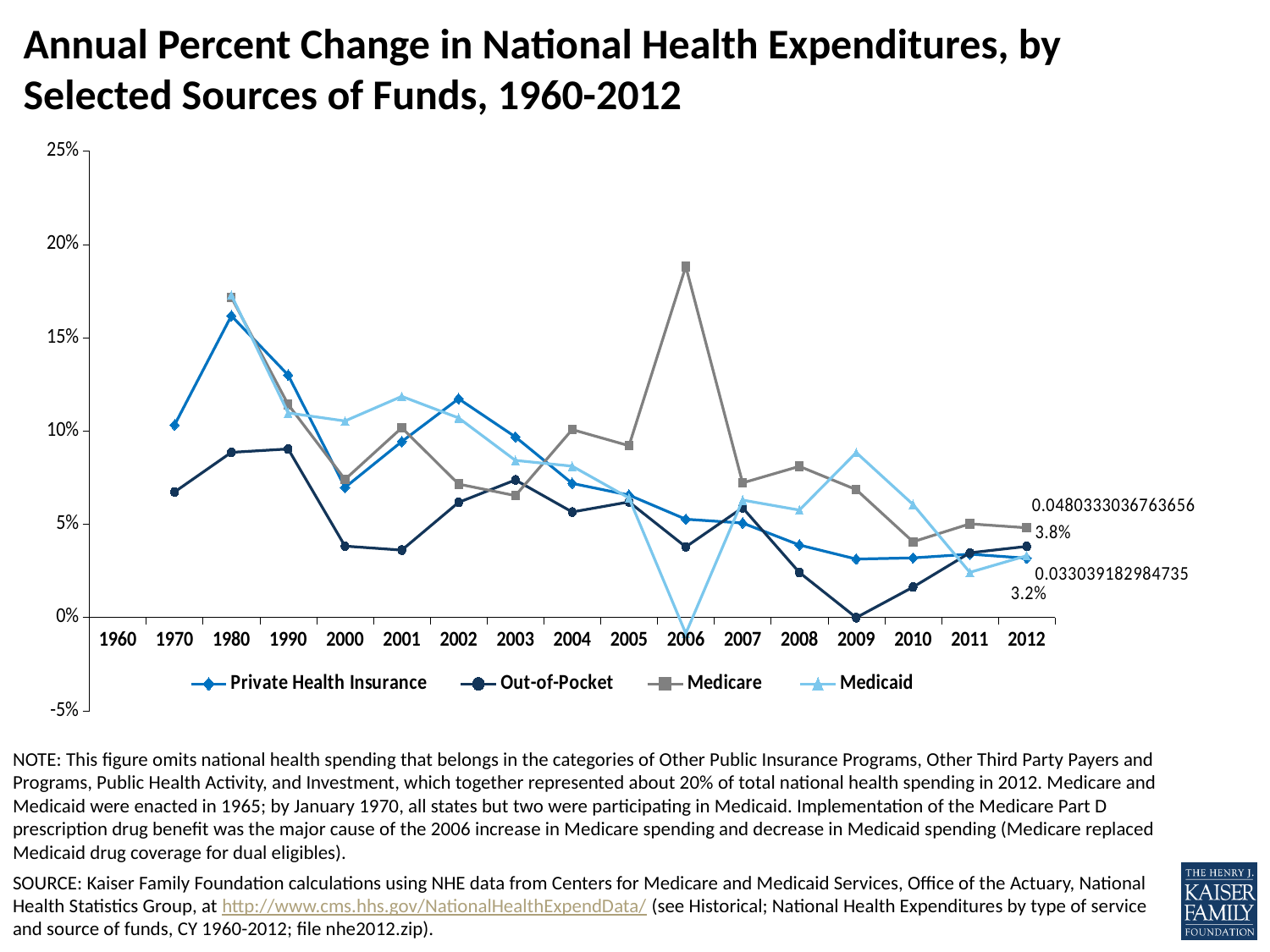
What is the difference between the 2012 values for Out-of-Pocket and Private Health Insurance? 0.6 percentage points In which year does the Medicare series reach its highest value? 2006 What is the value for Private Health Insurance in 2012? 3.2% In 1980, which is larger: Private Health Insurance or Out-of-Pocket? Private Health Insurance What is the value for Out-of-Pocket in 2012? 3.8% Is the Medicare value for 2006 greater or less than 15%? greater Is the Medicaid value for 2006 greater or less than 0%? less What kind of chart is shown on the slide? line chart In which year is the Out-of-Pocket series at its lowest? 2009 How many years are labeled along the x axis? 17 Does the Private Health Insurance series rise or fall from 2002 to 2009? fall How many series does the legend list? 4